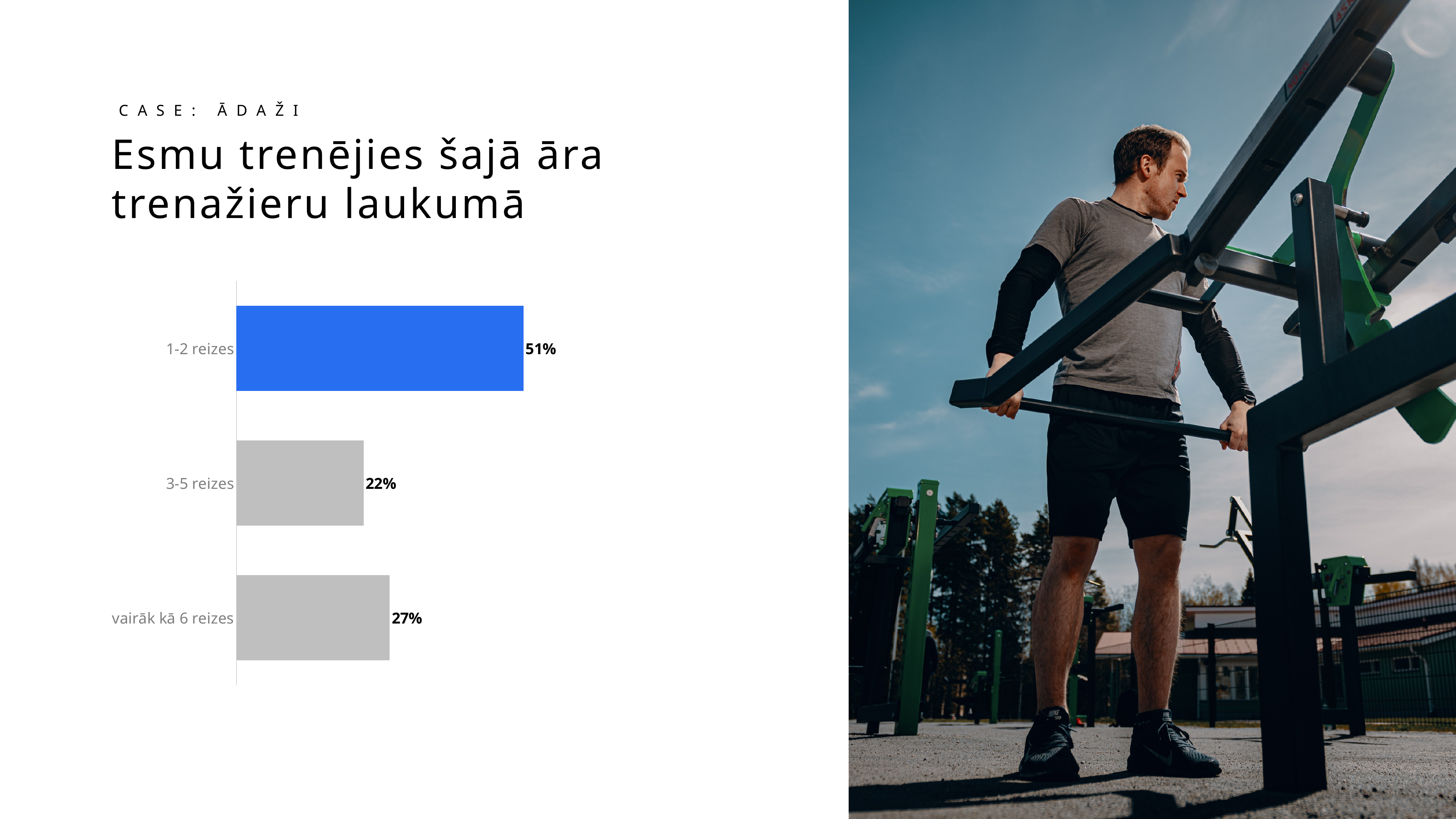
What is the difference between the values for "vairāk kā 6 reizes" and "3-5 reizes"? 5% What is the value for "3-5 reizes"? 22% What kind of chart is shown on the slide? bar chart How many categories does the chart show? 3 What is the value for "1-2 reizes"? 51% What is the difference between the values for "1-2 reizes" and "3-5 reizes"? 29% What is the value for "vairāk kā 6 reizes"? 27% Which is larger, the value for "3-5 reizes" or the value for "vairāk kā 6 reizes"? vairāk kā 6 reizes Which bar is coloured blue rather than grey? 1-2 reizes Which category has the lowest value? 3-5 reizes Which category has the highest value? 1-2 reizes What is the title of the slide above the chart? Esmu trenējies šajā āra trenažieru laukumā